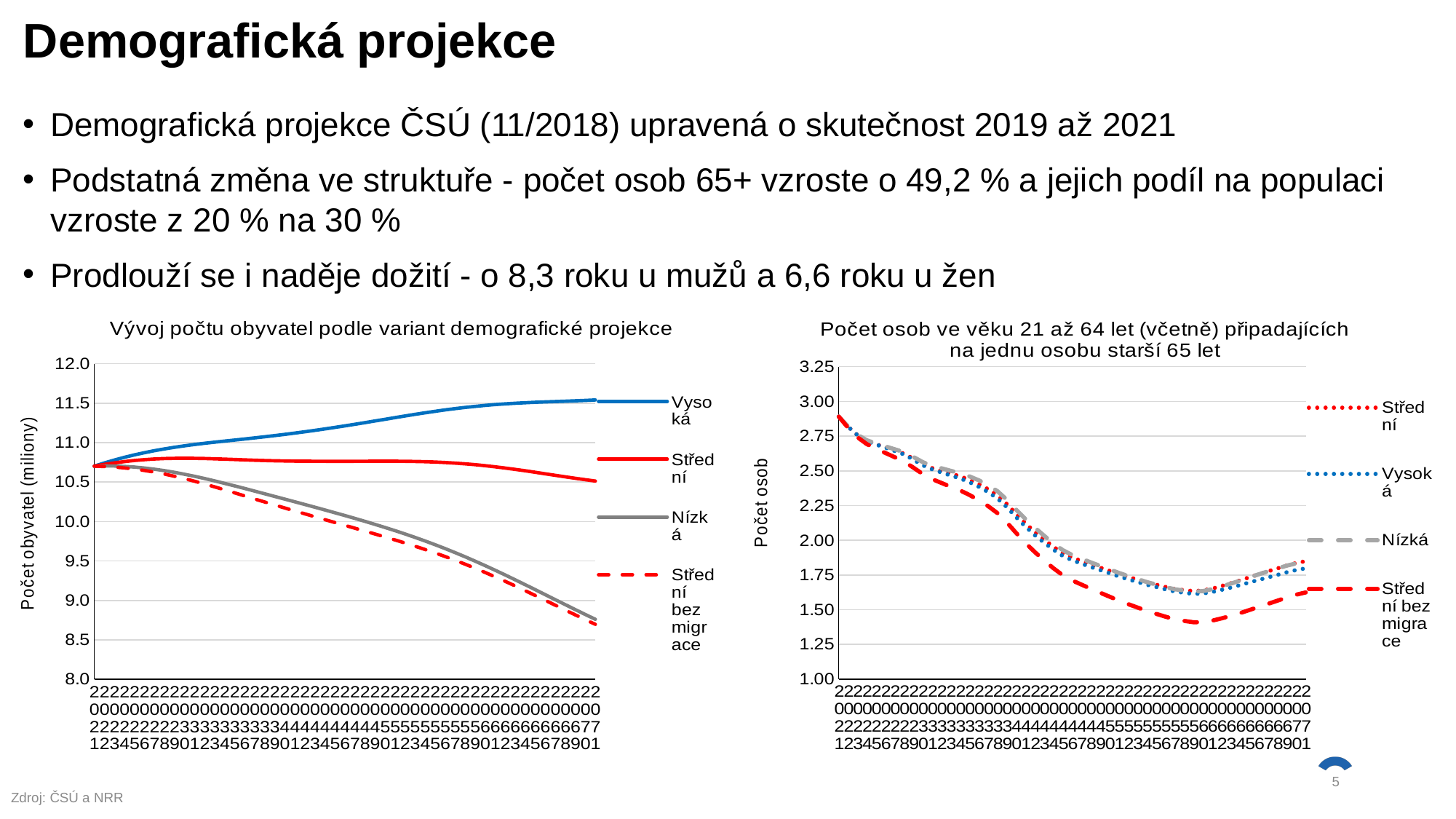
How many series does the legend of the left chart list? 4 In the right chart, is the lowest value of the 'Střední bez migrace' series greater or less than 1.50? less In the left chart, is the final value of the 'Nízká' series greater or less than 9.0? less What is the y-axis label of the left chart? Počet obyvatel (miliony) What kind of chart is the right chart titled 'Počet osob ve věku 21 až 64 let (včetně) připadajících na jednu osobu starší 65 let'? line chart In the left chart, is the final value of the 'Vysoká' series greater or less than 11.0? greater What kind of chart is the left chart titled 'Vývoj počtu obyvatel podle variant demografické projekce'? line chart In the left chart, does the 'Vysoká' series rise or fall along the x axis? rise How many series does the legend of the right chart list? 4 In the right chart, which series is lower at the end of the period, 'Střední' or 'Střední bez migrace'? Střední bez migrace In the left chart, which series has the highest value at the end of the period, 'Vysoká' or 'Nízká'? Vysoká In the left chart, does the 'Nízká' series rise or fall along the x axis? fall